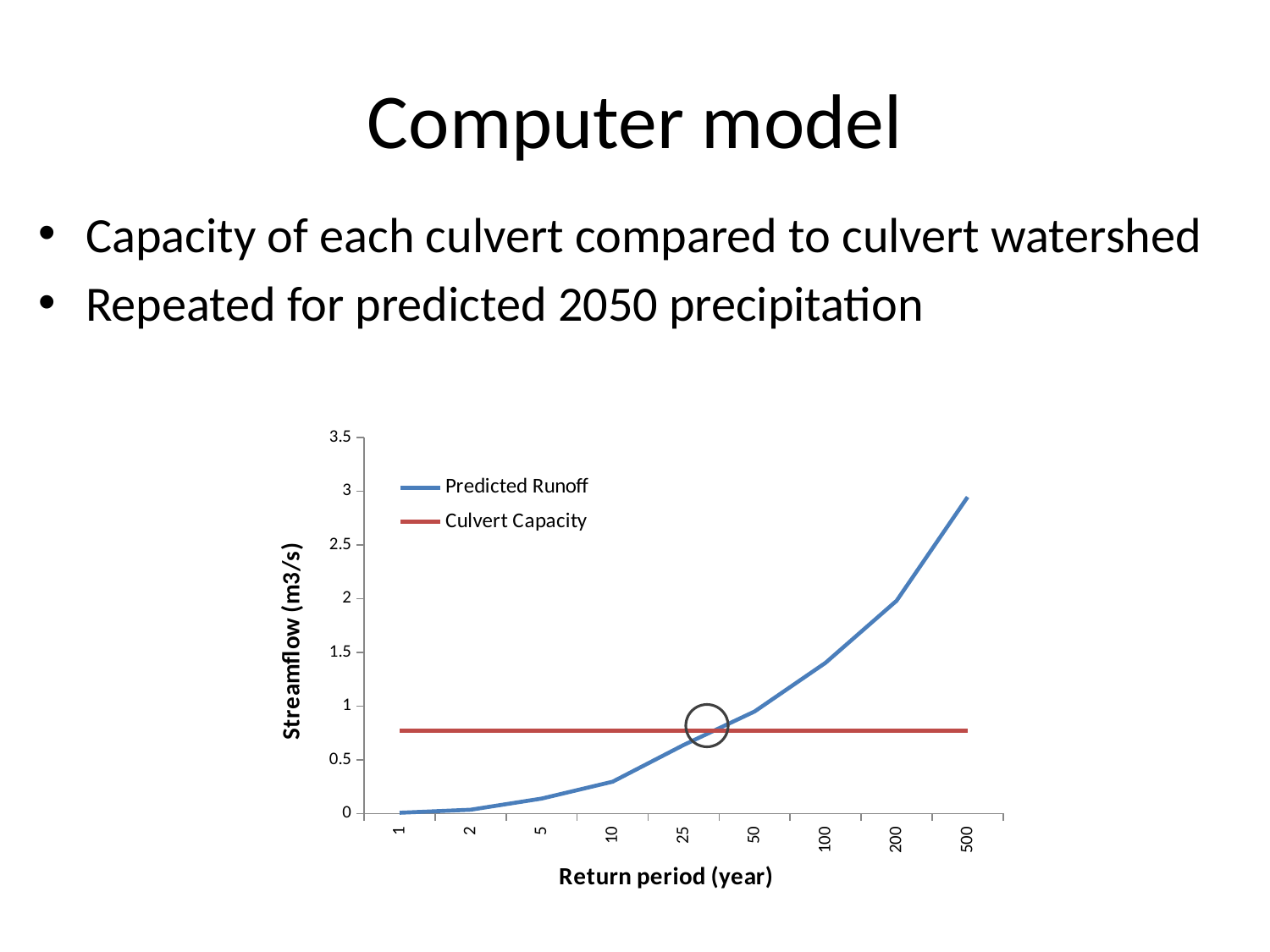
At which return period is Predicted Runoff lowest? 1 How many series does the chart legend list? 2 Does the Predicted Runoff line rise or fall as the return period increases? rises What is the label of the y axis? Streamflow (m3/s) What kind of chart is shown on the slide? line chart How many return period values are labelled on the x axis? 9 At which return period is Predicted Runoff highest? 500 At a return period of 500 years, which is larger: Predicted Runoff or Culvert Capacity? Predicted Runoff Is the Predicted Runoff value at a return period of 10 years greater or less than 0.5? less Does the Culvert Capacity line rise, fall or stay flat across the return periods? stays flat Is the Culvert Capacity value greater or less than 1? less Is the Predicted Runoff value at a return period of 500 years greater or less than 2.5? greater